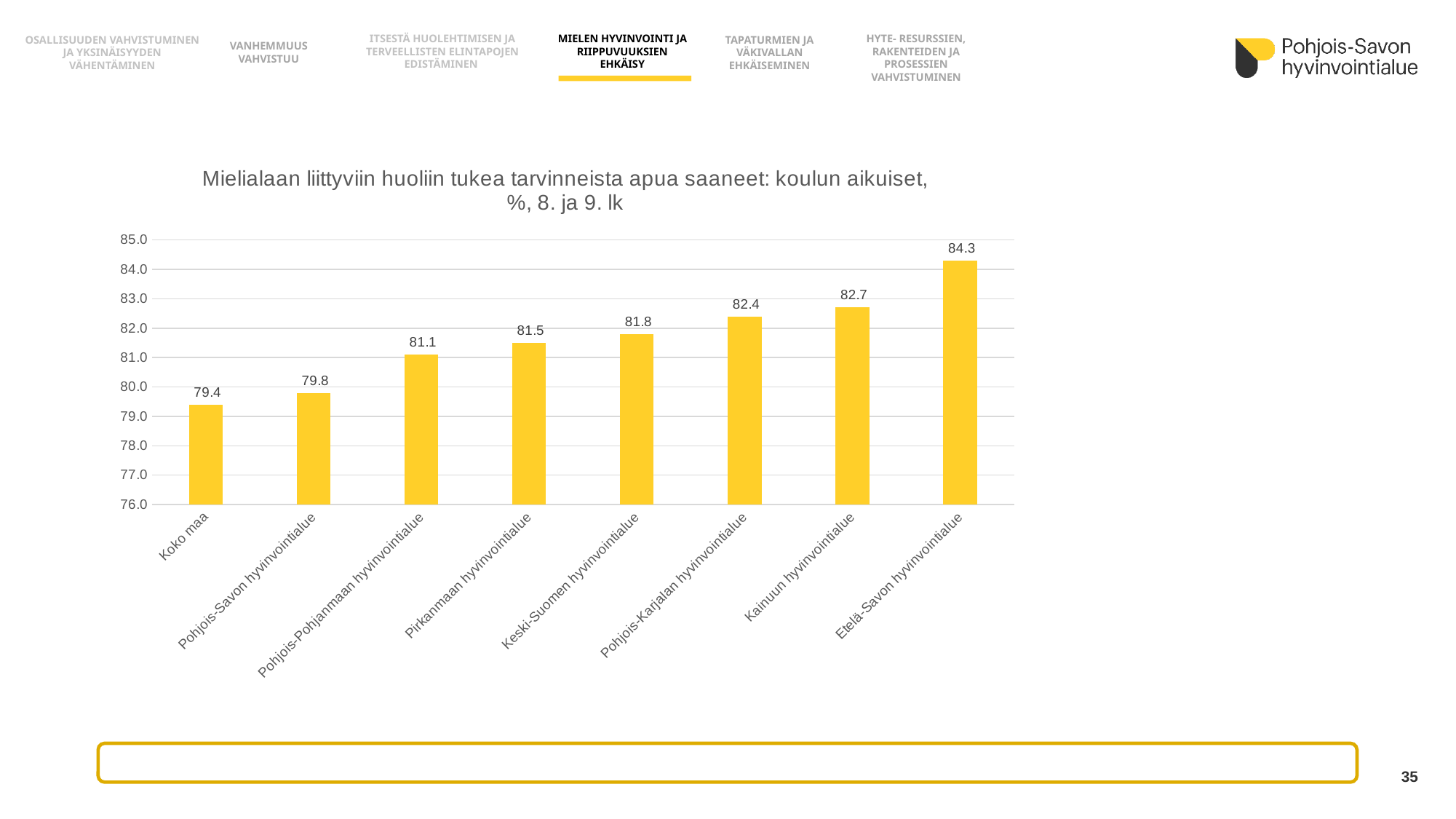
Which is larger, the value for Pirkanmaan hyvinvointialue or Keski-Suomen hyvinvointialue? Keski-Suomen hyvinvointialue How many categories are shown on the x axis? 8 What is the value for Kainuun hyvinvointialue? 82.7 What is the difference between Etelä-Savon hyvinvointialue and Koko maa? 4.9 Which category has the highest value? Etelä-Savon hyvinvointialue What is the value for Pohjois-Savon hyvinvointialue? 79.8 What is the difference between Pohjois-Karjalan hyvinvointialue and Pohjois-Savon hyvinvointialue? 2.6 What is the value for Koko maa? 79.4 Which category has the lowest value? Koko maa Is the value for Pohjois-Pohjanmaan hyvinvointialue greater or less than 80.0? greater Do the values rise or fall from left to right along the x axis? rise What kind of chart is shown on the slide? bar chart